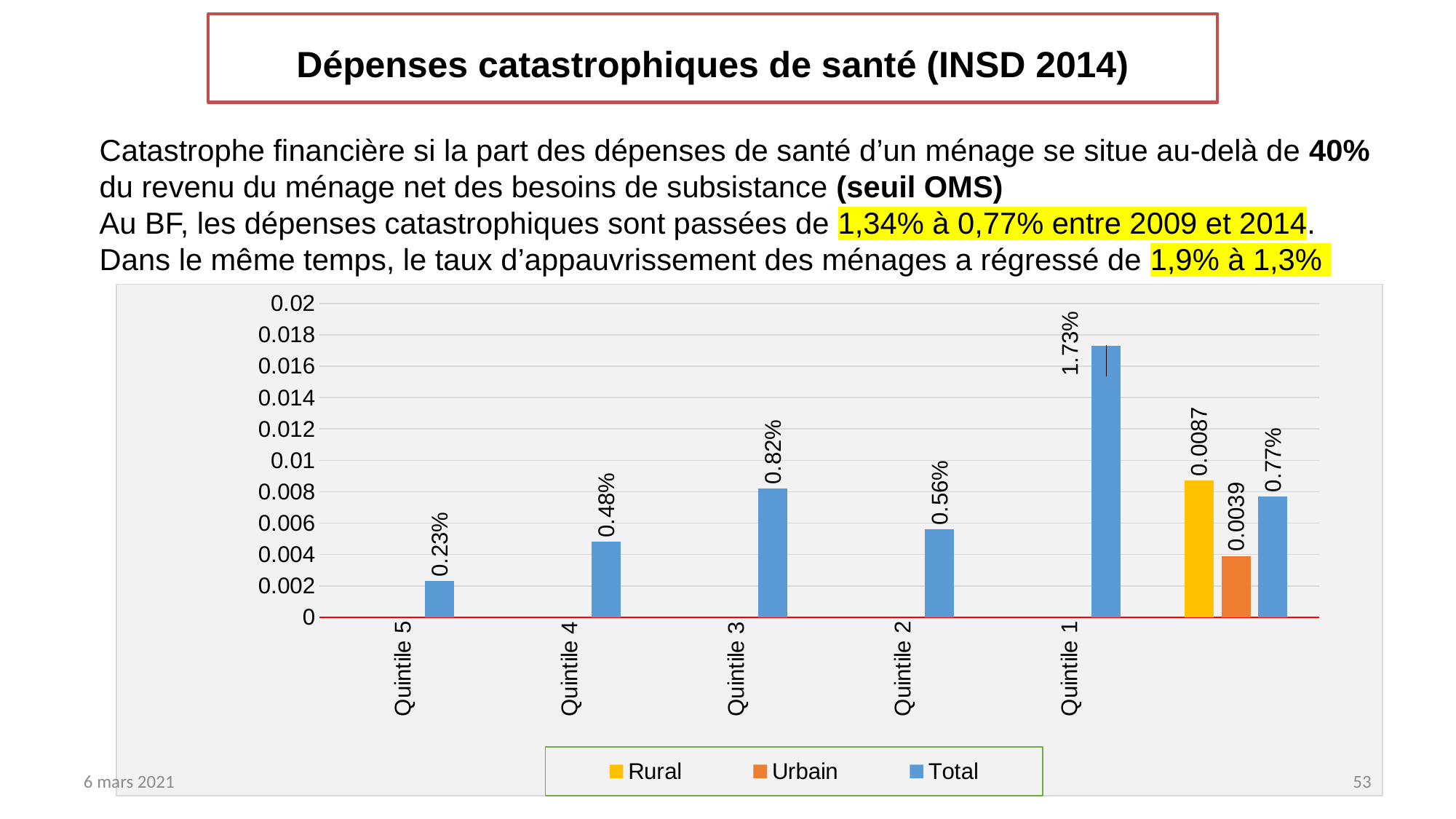
What kind of chart is shown on the slide? bar chart What is the value shown for Quintile 5? 0.23% What is the value of the Urbain bar? 0.0039 What is the difference between the values for Quintile 3 and Quintile 2? 0.26% What is the value of the Rural bar? 0.0087 Which is larger, the value for Quintile 4 or the value for Quintile 2? Quintile 2 Which quintile has the lowest value? Quintile 5 What is the value shown for Quintile 3? 0.82% How many series does the legend list? 3 Which quintile has the highest value? Quintile 1 What is the value shown for Quintile 1? 1.73% Is the value for Quintile 1 greater or less than 0.016? greater